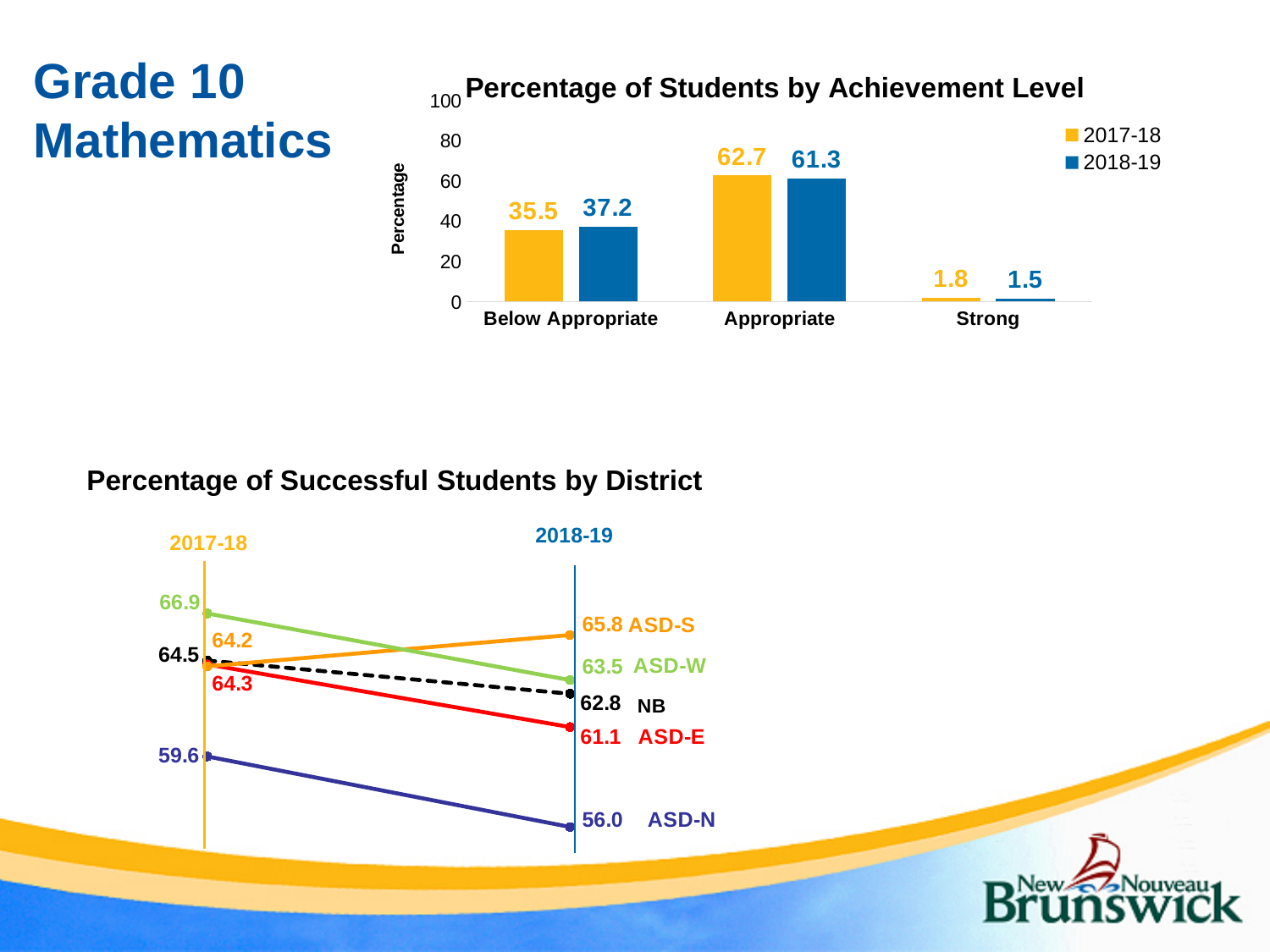
In the 'Percentage of Successful Students by District' chart, which district has the lowest 2018-19 value? ASD-N In the 'Percentage of Students by Achievement Level' chart, what is the difference between the 2017-18 and 2018-19 values for Strong? 0.3 In the 'Percentage of Students by Achievement Level' chart, which is larger for Below Appropriate: the 2017-18 value or the 2018-19 value? 2018-19 In the 'Percentage of Students by Achievement Level' chart, what is the 2018-19 value for Below Appropriate? 37.2 What kind of chart is 'Percentage of Students by Achievement Level'? Bar chart In the 'Percentage of Successful Students by District' chart, what is the 2017-18 value for NB? 64.5 In the 'Percentage of Students by Achievement Level' chart, which achievement level has the lowest 2018-19 value? Strong In the 'Percentage of Students by Achievement Level' chart, how many series does the legend list? 2 In the 'Percentage of Successful Students by District' chart, does the value for ASD-W rise or fall from 2017-18 to 2018-19? Fall In the 'Percentage of Successful Students by District' chart, what is the 2018-19 value for ASD-S? 65.8 In the 'Percentage of Successful Students by District' chart, what is the difference between the 2017-18 and 2018-19 values for ASD-N? 3.6 In the 'Percentage of Students by Achievement Level' chart, what is the 2017-18 value for Appropriate? 62.7